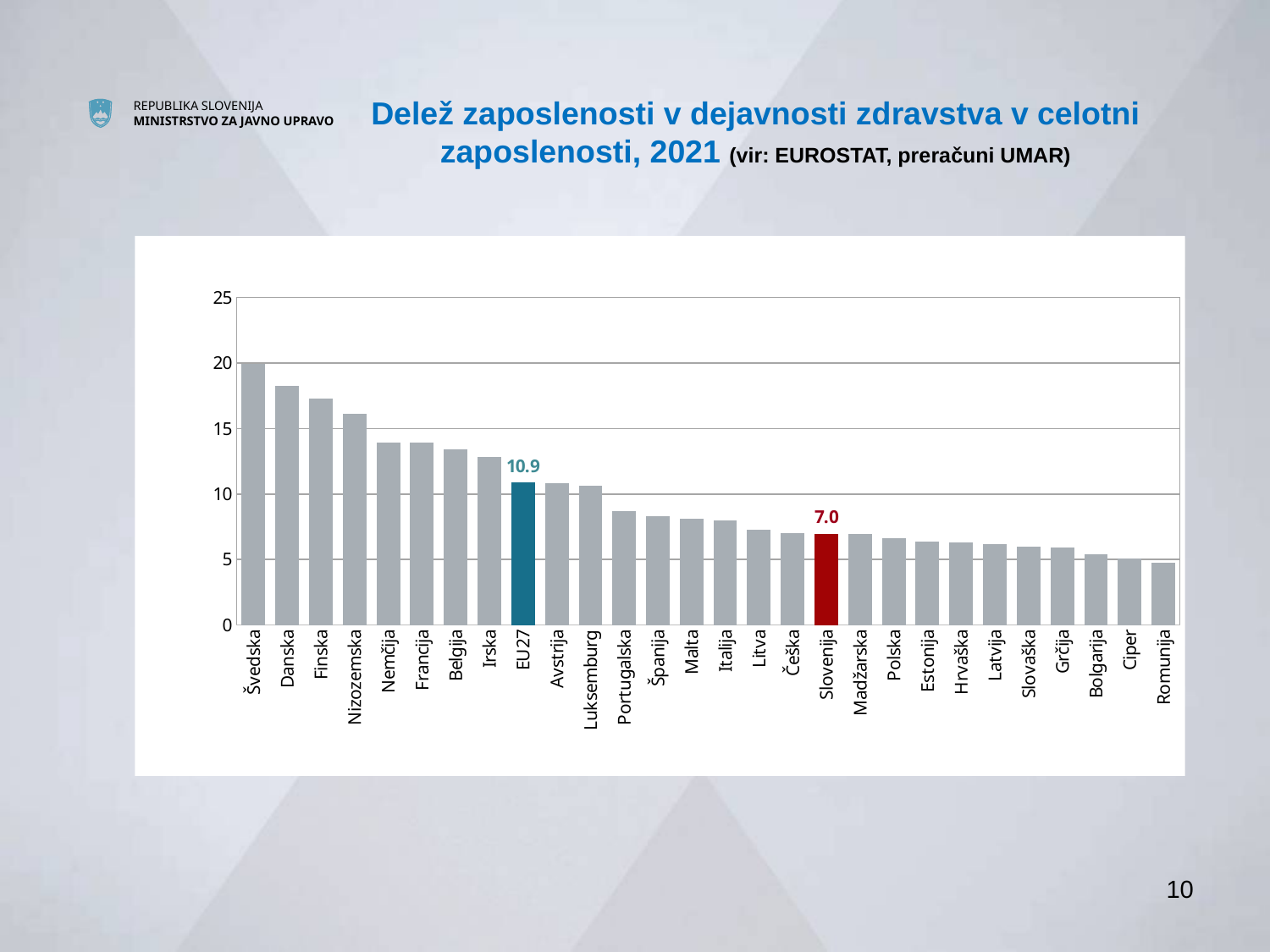
Is the value for Portugalska greater or less than 10? less Which country has the highest bar in the chart? Švedska Which country has the lowest bar in the chart? Romunija How many countries/categories are shown on the x axis? 28 What is the difference between the values for EU27 and Slovenija? 3.9 What kind of chart is shown on the slide? Bar chart Which is larger, the value for EU27 or the value for Slovenija? EU27 What is the value shown for EU27? 10.9 Is the value for Švedska greater or less than 15? greater What is the value shown for Slovenija? 7.0 Is the value for Nizozemska greater or less than 15? greater Do the values rise or fall moving from left to right along the x axis? Fall